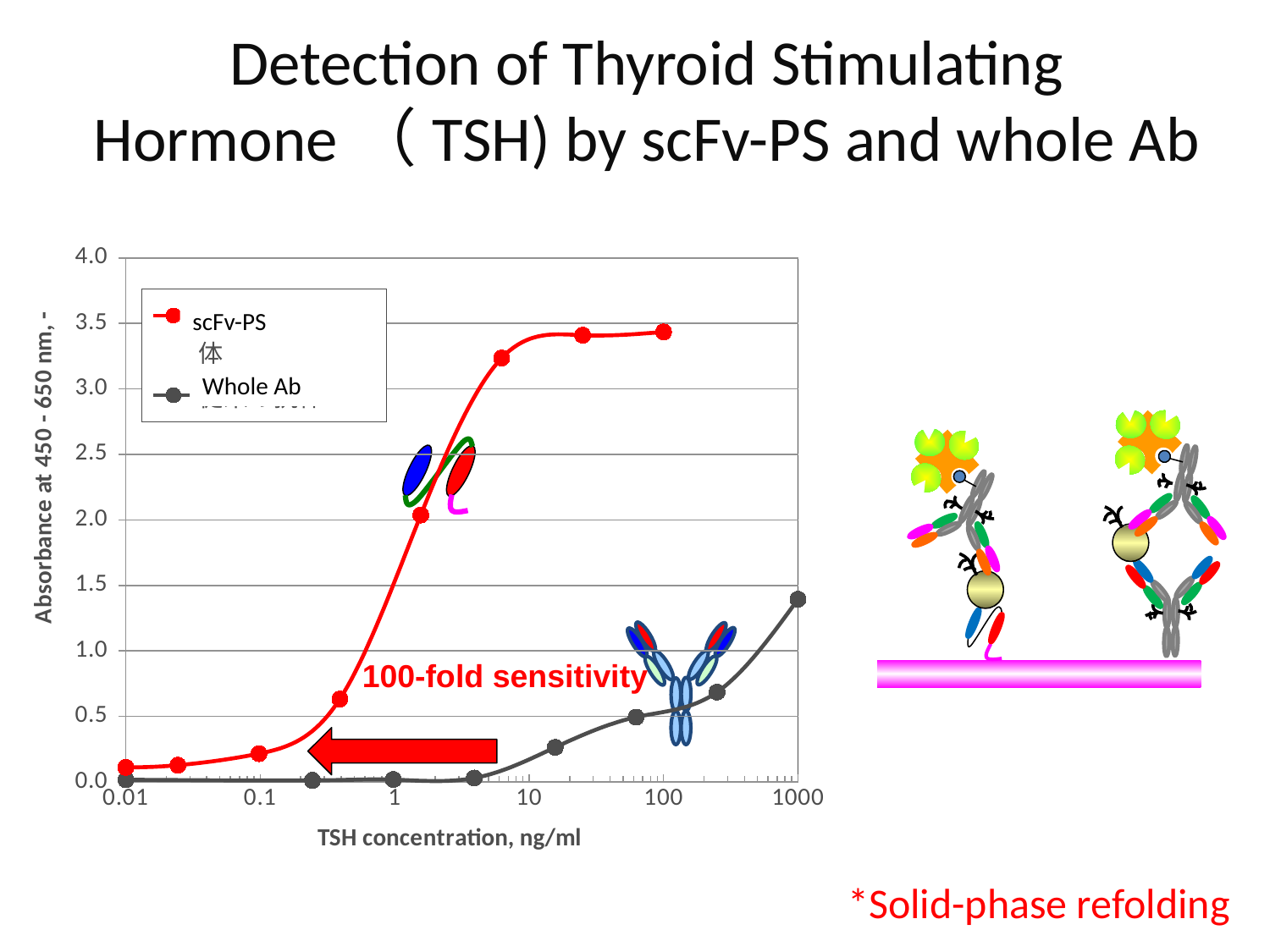
Which series reaches the higher absorbance values in the chart? scFv-PS How many series does the chart legend list? 2 Is the absorbance for scFv-PS at 100 ng/ml greater or less than 3.0? greater Does the absorbance for the scFv-PS series rise or fall as TSH concentration increases? rise Is the absorbance for scFv-PS at 0.1 ng/ml greater or less than 0.5? less What kind of chart is shown on the slide? line chart Is the absorbance for Whole Ab at 1000 ng/ml greater or less than 1.0? greater Which series has the lower absorbance at a TSH concentration of 10 ng/ml? Whole Ab What is the x-axis title of the chart? TSH concentration, ng/ml At a TSH concentration of 1 ng/ml, which series has the larger absorbance, scFv-PS or Whole Ab? scFv-PS How many data points are plotted for the scFv-PS series? 8 What are the two series named in the chart legend? scFv-PS and Whole Ab